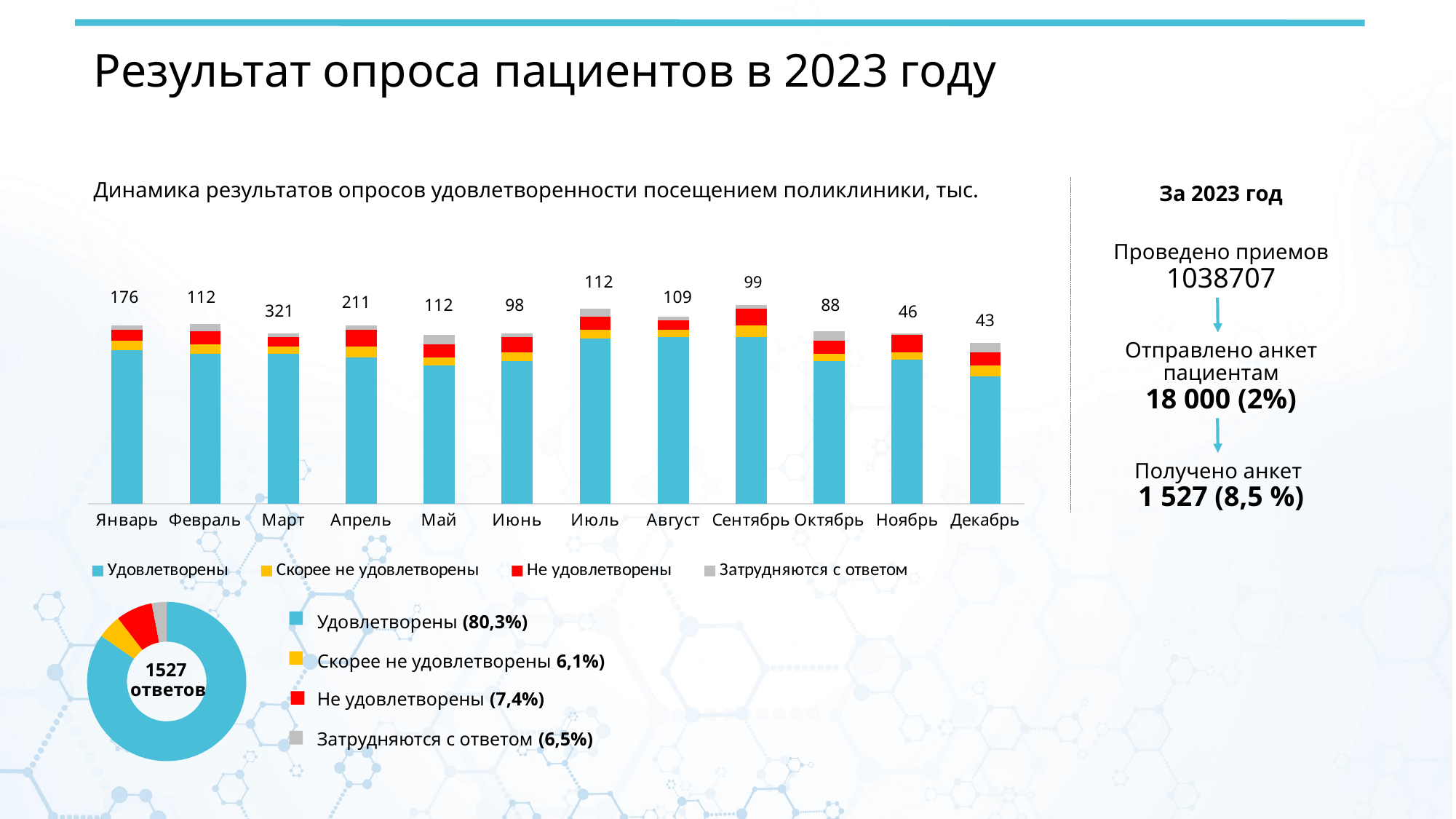
In the donut chart, what share of responses is Удовлетворены? 80,3% In the bar chart, what value is labelled above the bar for Сентябрь? 99 What total number of responses is shown in the centre of the donut chart? 1527 ответов In the bar chart, which has the larger labelled value, Январь or Октябрь? Январь In the bar chart, what value is labelled above the bar for Декабрь? 43 In the bar chart, which month has the lowest labelled value? Декабрь What kind of chart is the monthly chart at the top of the slide? Stacked bar chart In the bar chart, which month has the highest labelled value? Март How many series does the legend of the bar chart list? 4 How many months are shown on the x axis of the bar chart? 12 In the bar chart, what value is labelled above the bar for Март? 321 In the bar chart, what is the difference between the labelled values for Март and Апрель? 110